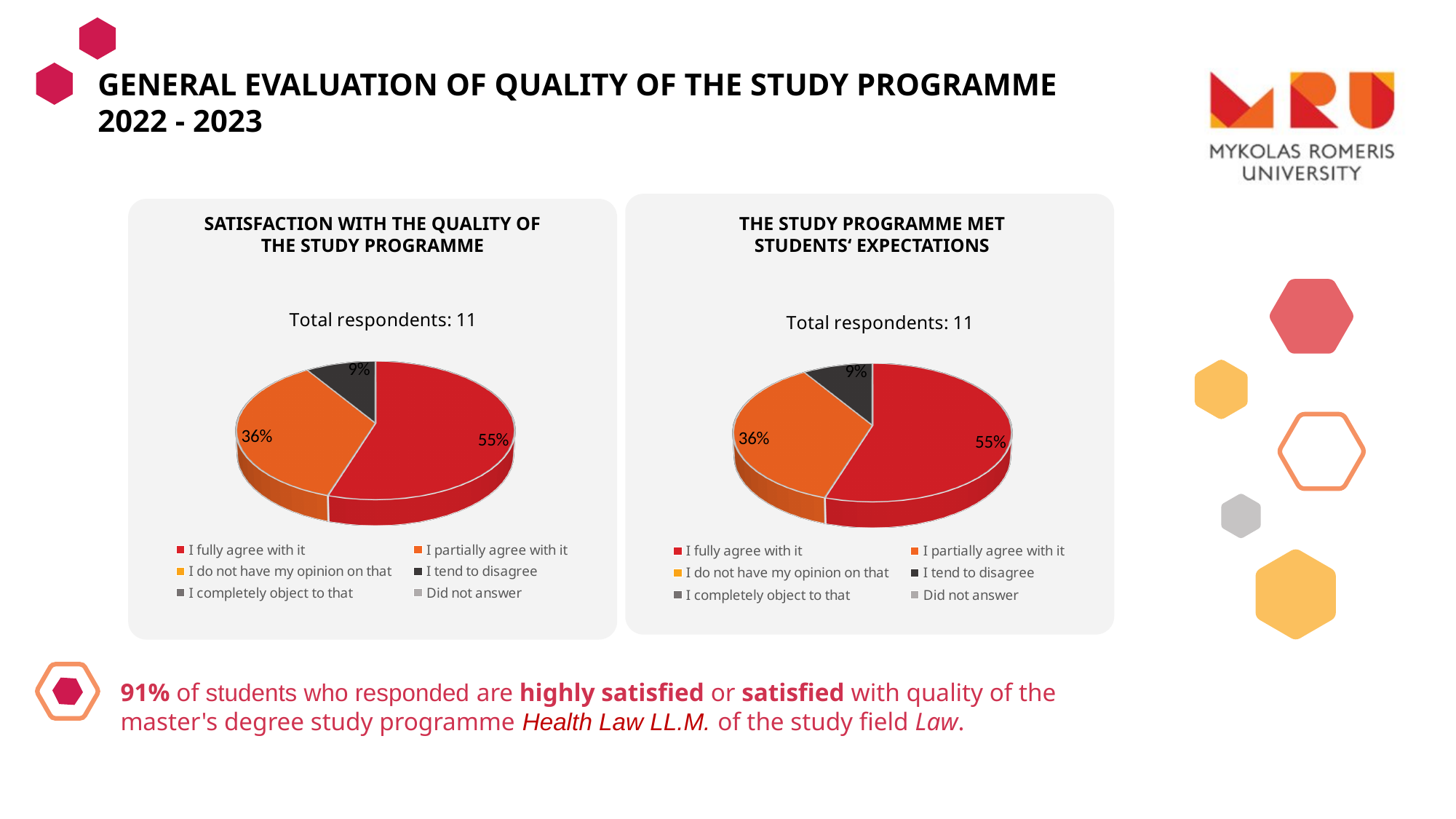
In the 'Satisfaction with the quality of the study programme' chart, what share of respondents fully agree with it? 55% In the 'Satisfaction with the quality of the study programme' chart, what is the difference in percentage points between 'I fully agree with it' and 'I partially agree with it'? 19 In the 'Satisfaction with the quality of the study programme' chart, what share of respondents partially agree with it? 36% In the 'The study programme met students' expectations' chart, which labelled response has the smallest slice? I tend to disagree In the 'Satisfaction with the quality of the study programme' chart, which response has the largest slice? I fully agree with it In the 'The study programme met students' expectations' chart, what share of respondents tend to disagree? 9% How many entries does the legend of the 'The study programme met students' expectations' chart list? 6 In the 'The study programme met students' expectations' chart, which is larger: 'I partially agree with it' or 'I tend to disagree'? I partially agree with it In the 'The study programme met students' expectations' chart, what share of respondents fully agree with it? 55% What type of chart is used in the 'Satisfaction with the quality of the study programme' panel? Pie chart How many total respondents are reported for the 'Satisfaction with the quality of the study programme' chart? 11 In the 'Satisfaction with the quality of the study programme' chart, what share of respondents tend to disagree? 9%